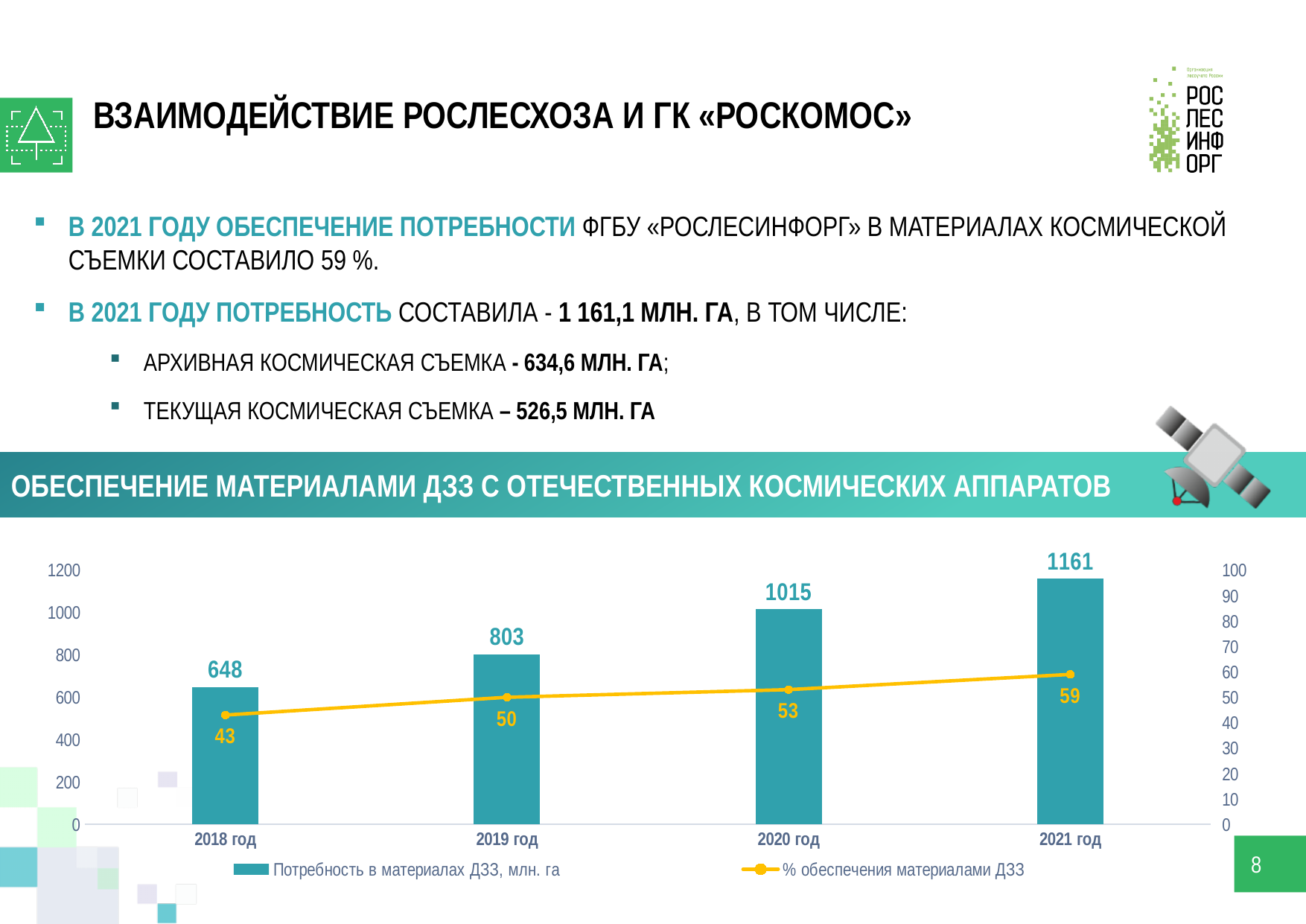
What is the '% обеспечения материалами ДЗЗ' value for 2020 год? 53 Which is larger: the 'Потребность в материалах ДЗЗ, млн. га' for 2019 год or for 2020 год? 2020 год Which year has the lowest '% обеспечения материалами ДЗЗ'? 2018 год How many series does the chart legend list? 2 What kind of chart is used to show 'Потребность в материалах ДЗЗ, млн. га'? bar chart What is the difference in 'Потребность в материалах ДЗЗ, млн. га' between 2021 год and 2018 год? 513 Is the 'Потребность в материалах ДЗЗ, млн. га' for 2020 год greater or less than 1000? greater Which year has the highest 'Потребность в материалах ДЗЗ, млн. га'? 2021 год What is the value of 'Потребность в материалах ДЗЗ, млн. га' for 2019 год? 803 What colour is the '% обеспечения материалами ДЗЗ' line in the chart? yellow Does the '% обеспечения материалами ДЗЗ' line rise or fall from 2018 год to 2021 год? rise How many years are shown on the x axis of the chart? 4